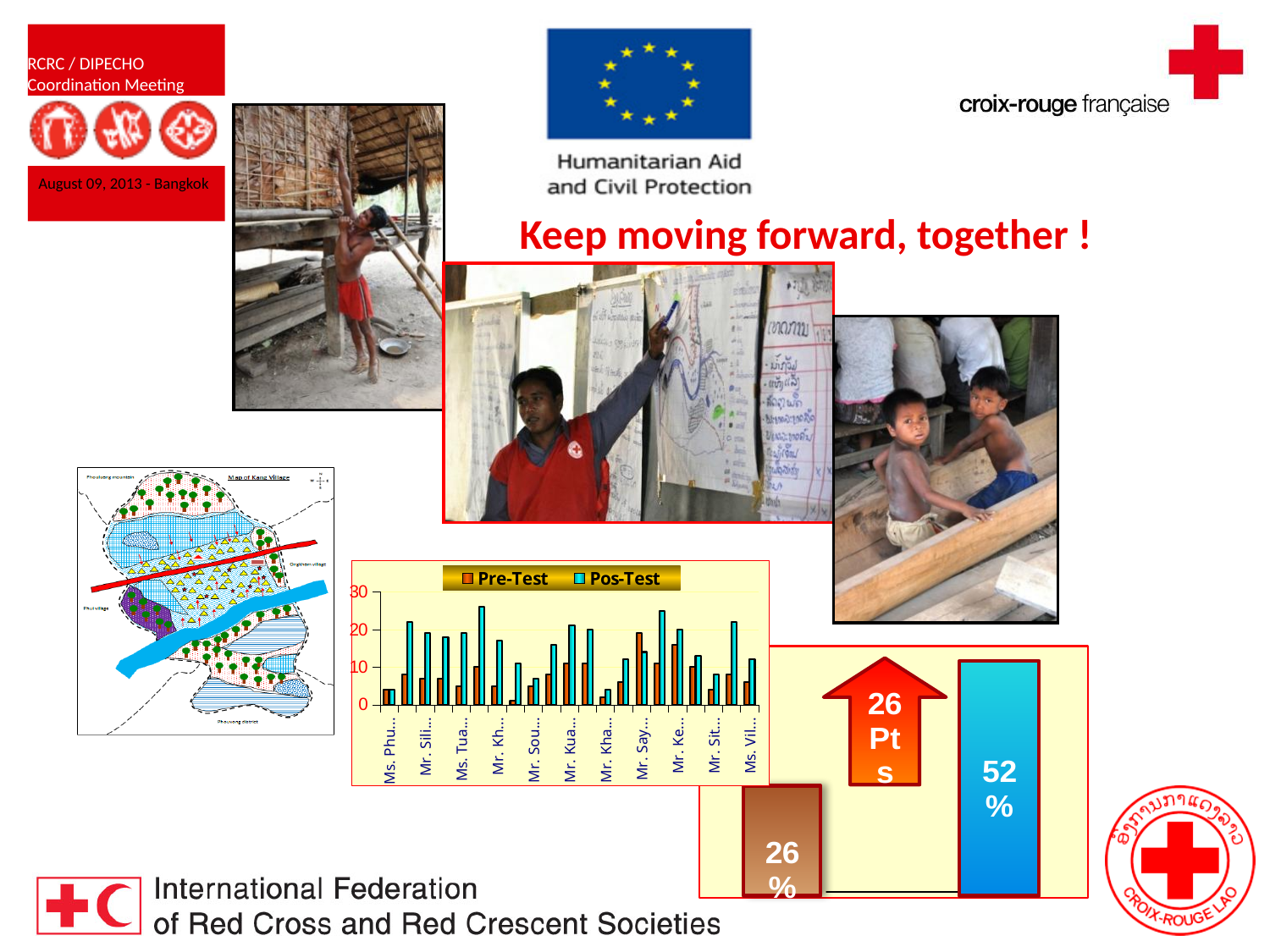
What kind of chart is the Pre-Test / Pos-Test chart in the lower middle of the slide? bar chart What are the two series named in the legend of the bar chart? Pre-Test and Pos-Test How many series does the legend of the Pre-Test / Pos-Test bar chart list? 2 In the bar chart, is the Pos-Test value for Ms. Phu... greater or less than 10? less In the two-bar graphic at the lower right of the slide, what value is printed on the brown bar? 26 % In the two-bar graphic at the lower right of the slide, what value is printed on the blue bar? 52 % In the two-bar graphic at the lower right of the slide, what increase does the arrow indicate between the brown bar and the blue bar? 26 Pts In the bar chart, is the Pre-Test value for Mr. Say... greater or less than 10? greater In the bar chart, which colour represents the Pos-Test series? blue In the bar chart, is the Pre-Test value for Ms. Phu... greater or less than 10? less In the bar chart, for Mr. Sili..., which is larger, the Pre-Test or the Pos-Test value? Pos-Test